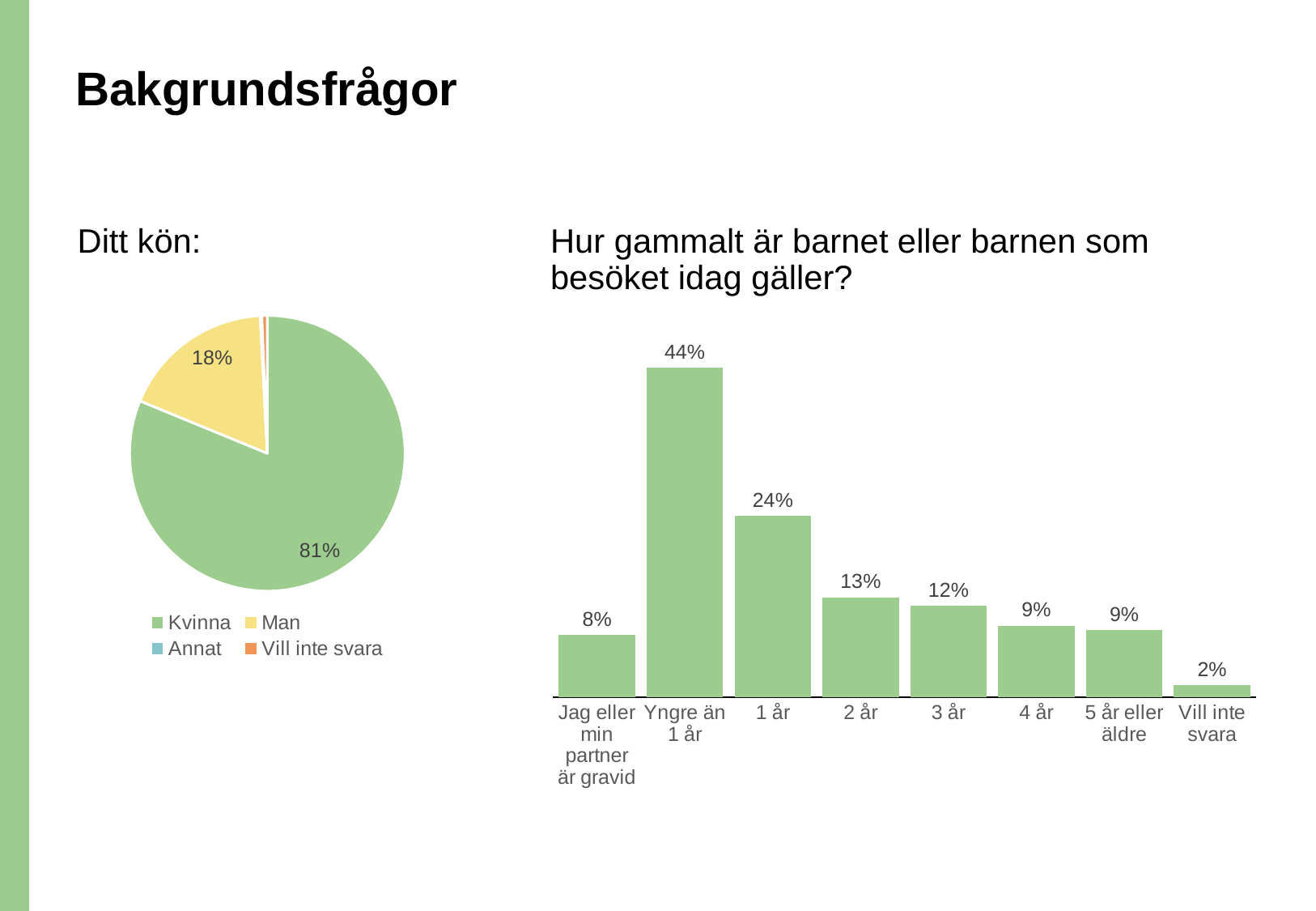
In the "Hur gammalt är barnet eller barnen som besöket idag gäller?" bar chart, how many categories are shown? 8 What kind of chart is the "Hur gammalt är barnet eller barnen som besöket idag gäller?" chart? bar chart In the "Hur gammalt är barnet eller barnen som besöket idag gäller?" bar chart, which is larger, "2 år" or "4 år"? 2 år In the "Hur gammalt är barnet eller barnen som besöket idag gäller?" bar chart, which category has the highest value? Yngre än 1 år In the "Hur gammalt är barnet eller barnen som besöket idag gäller?" bar chart, what is the difference between "Yngre än 1 år" and "1 år"? 20% In the "Hur gammalt är barnet eller barnen som besöket idag gäller?" bar chart, what is the value for "3 år"? 12% In the "Ditt kön:" pie chart, what share is labelled for Man? 18% In the "Hur gammalt är barnet eller barnen som besöket idag gäller?" bar chart, which category has the lowest value? Vill inte svara In the "Ditt kön:" pie chart, what is the difference between the Kvinna and Man shares? 63% In the "Hur gammalt är barnet eller barnen som besöket idag gäller?" bar chart, what is the value for "Yngre än 1 år"? 44% In the "Ditt kön:" pie chart, what share is labelled for Kvinna? 81% In the "Ditt kön:" pie chart, how many entries does the legend list? 4